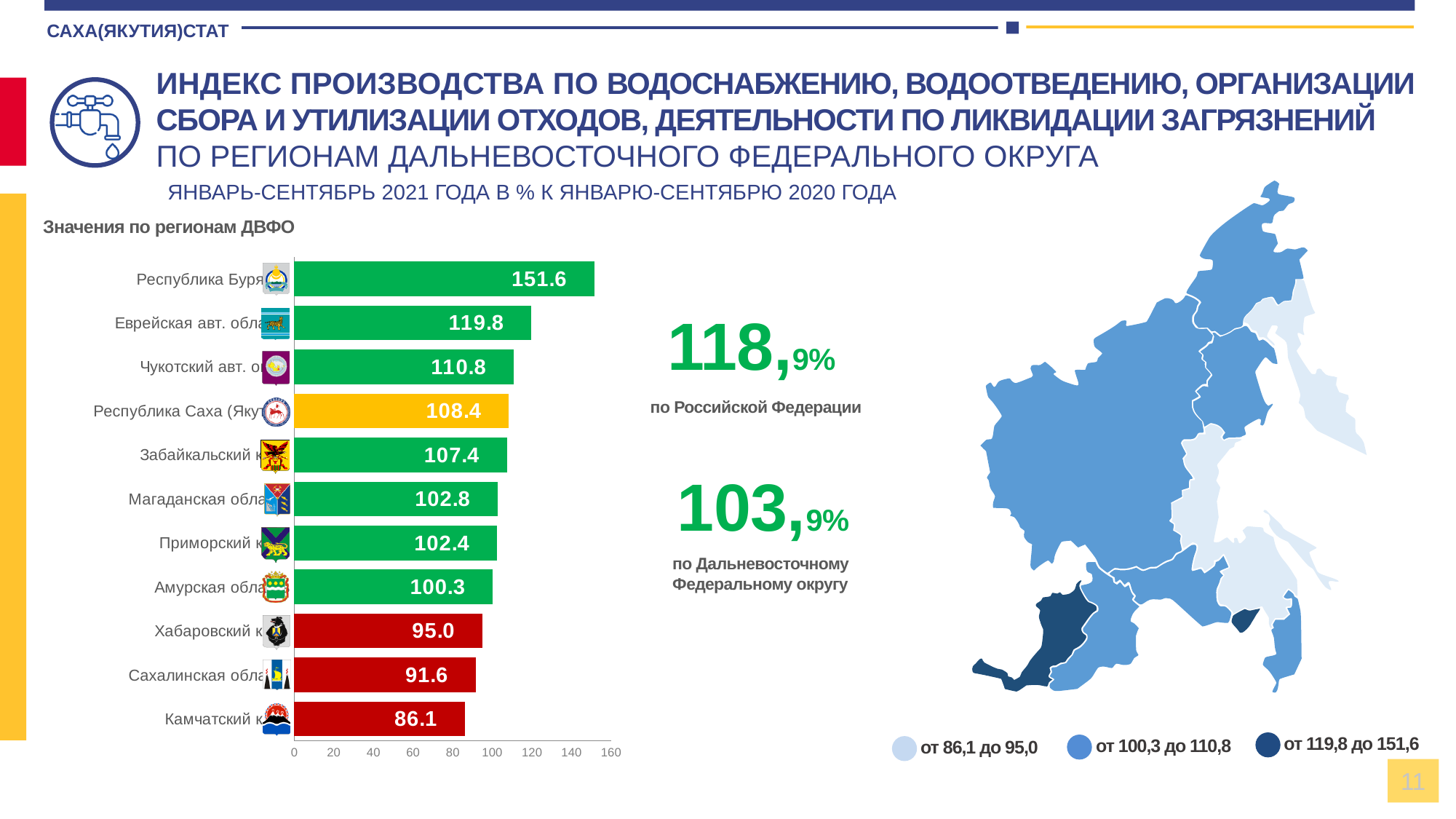
Which region has the lowest value in the bar chart? Камчатский край What is the difference between the values for Амурская область and Камчатский край? 14.2 What is the value shown for Магаданская область? 102.8 What is the difference between the values for Республика Бурятия and Еврейская авт. область? 31.8 How many regions are shown in the bar chart? 11 What is the value shown for Камчатский край? 86.1 What type of chart is used to show the values by region? bar chart Which region has the highest value in the bar chart? Республика Бурятия What is the value shown for Республика Саха (Якутия)? 108.4 What is the value shown for Республика Бурятия? 151.6 Which has a larger value, Хабаровский край or Сахалинская область? Хабаровский край What colour are the bars for regions with values below 100? red